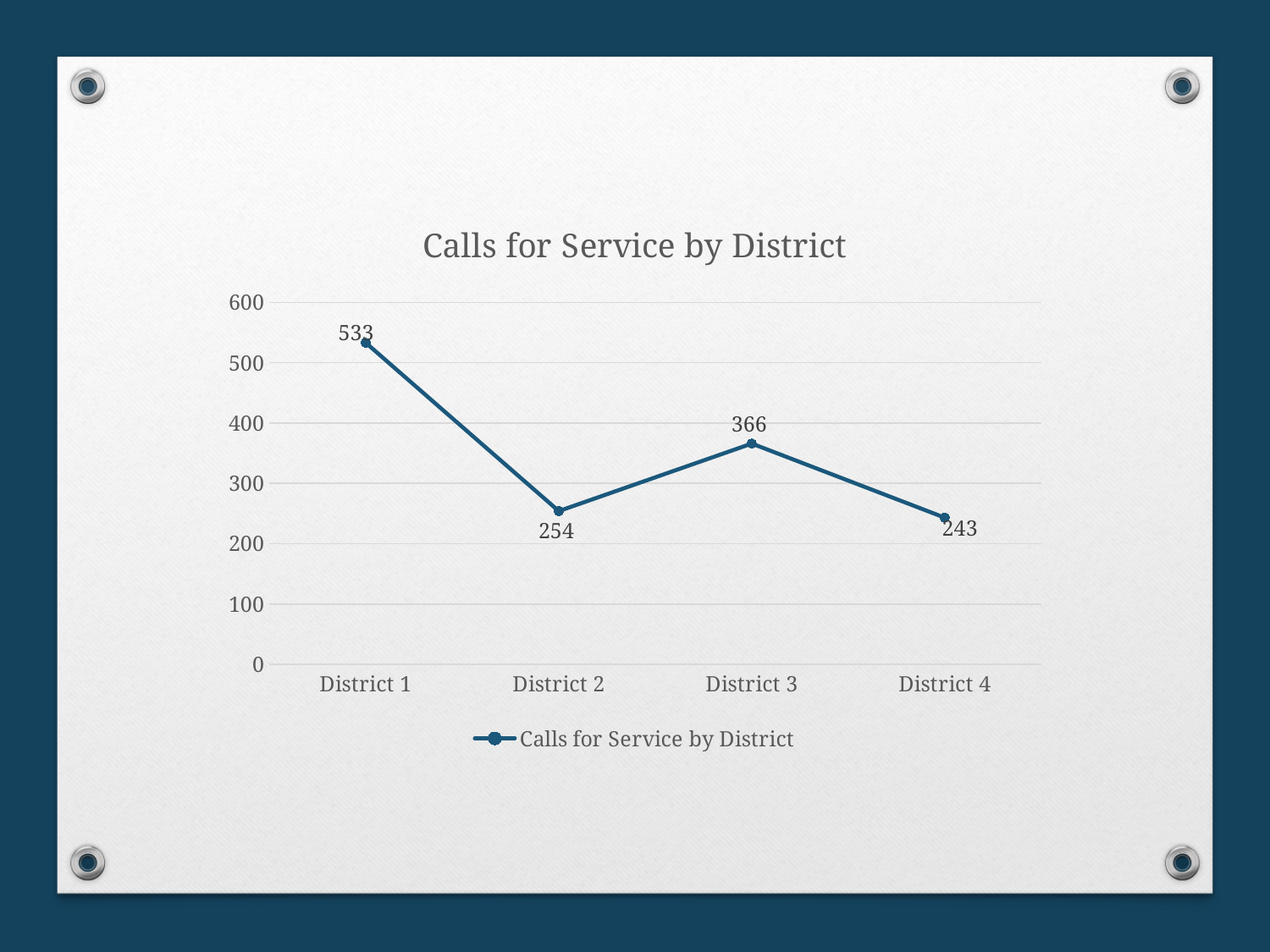
Which district has the highest number of calls for service? District 1 What is the value for District 1? 533 What is the difference between the values for District 3 and District 4? 123 What is the value for District 4? 243 Is the value for District 1 greater or less than 500? greater What is the difference between the values for District 1 and District 2? 279 How many districts are shown on the x axis? 4 Which is larger, the value for District 2 or District 3? District 3 What kind of chart is this? line chart What is the value for District 3? 366 Which district has the lowest number of calls for service? District 4 What is the title of the chart? Calls for Service by District